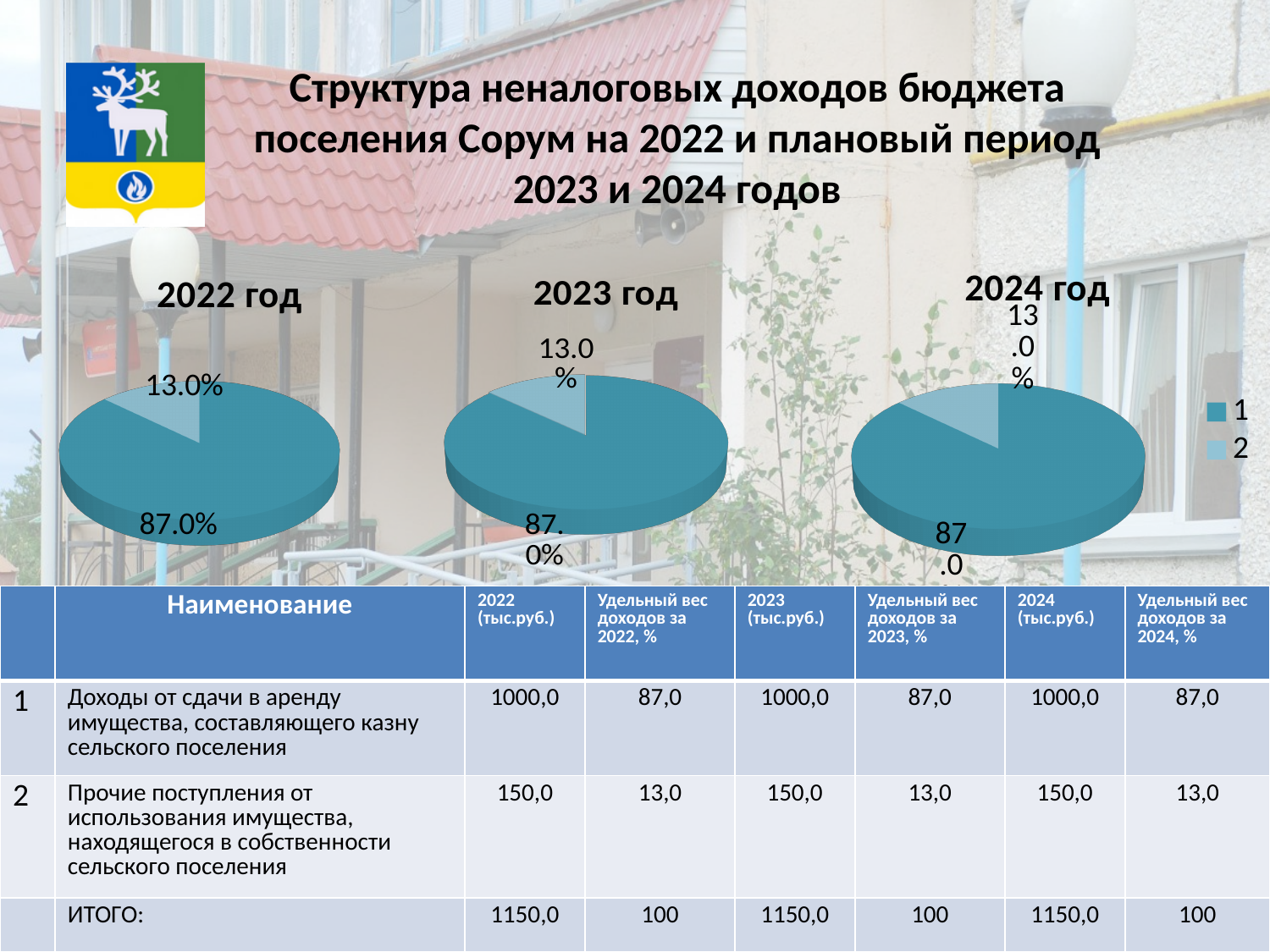
In the "2022 год" chart, which legend entry has the largest slice? 1 How many slices does the "2024 год" pie chart have? 2 How many entries does the legend list? 2 In the "2022 год" chart, what percentage is shown for the larger slice? 87.0% In the "2023 год" chart, what percentage is shown for the larger slice? 87.0% In the "2024 год" chart, what share does legend entry 2 have? 13.0% In the "2023 год" chart, which legend entry has the smallest slice? 2 In the "2022 год" chart, what percentage is shown for the smaller slice? 13.0% In the "2023 год" chart, what is the difference between the larger and smaller slice percentages? 74.0% In the "2023 год" chart, what percentage is shown for the smaller slice? 13.0% What kind of chart is the "2022 год" chart? pie chart How many pie charts are shown on the slide? 3